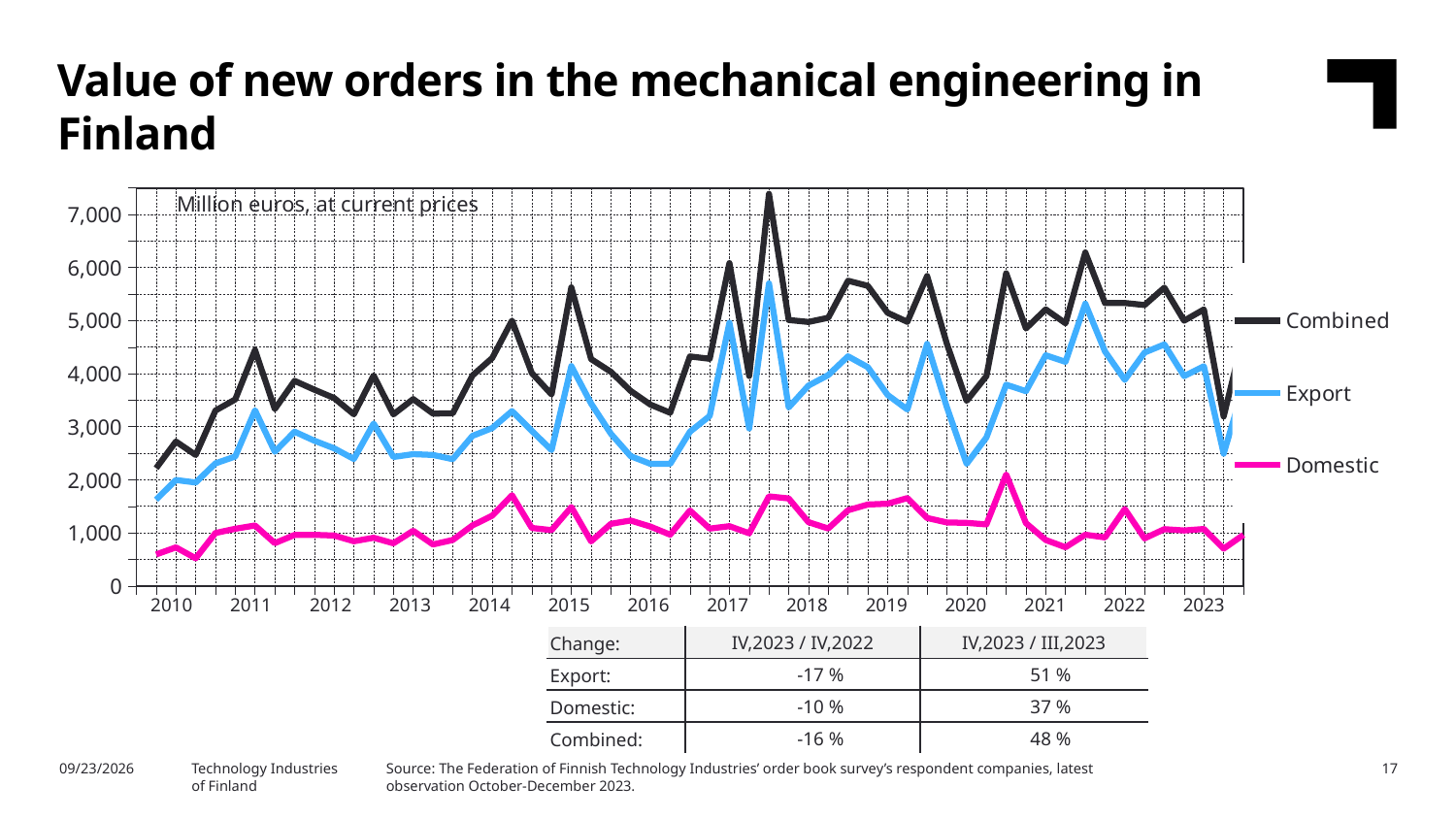
What unit is stated in the chart's subtitle? Million euros, at current prices Is the first value of the Export series in 2010 greater or less than 2,000? less What are the three series named in the legend? Combined, Export, Domestic What kind of chart is shown on the slide? Line chart Is the peak value of the Combined series in 2017 greater or less than 7,000? greater Which series has the lowest values throughout the chart? Domestic Is the first value of the Domestic series in 2010 greater or less than 1,000? less How many series does the legend list? 3 How many year labels are shown on the x axis? 14 Which is larger at the start of 2010, the Combined value or the Export value? Combined Which series has the highest values throughout the chart? Combined Does the Combined series rise or fall from the start of 2010 to the start of 2011? Rise